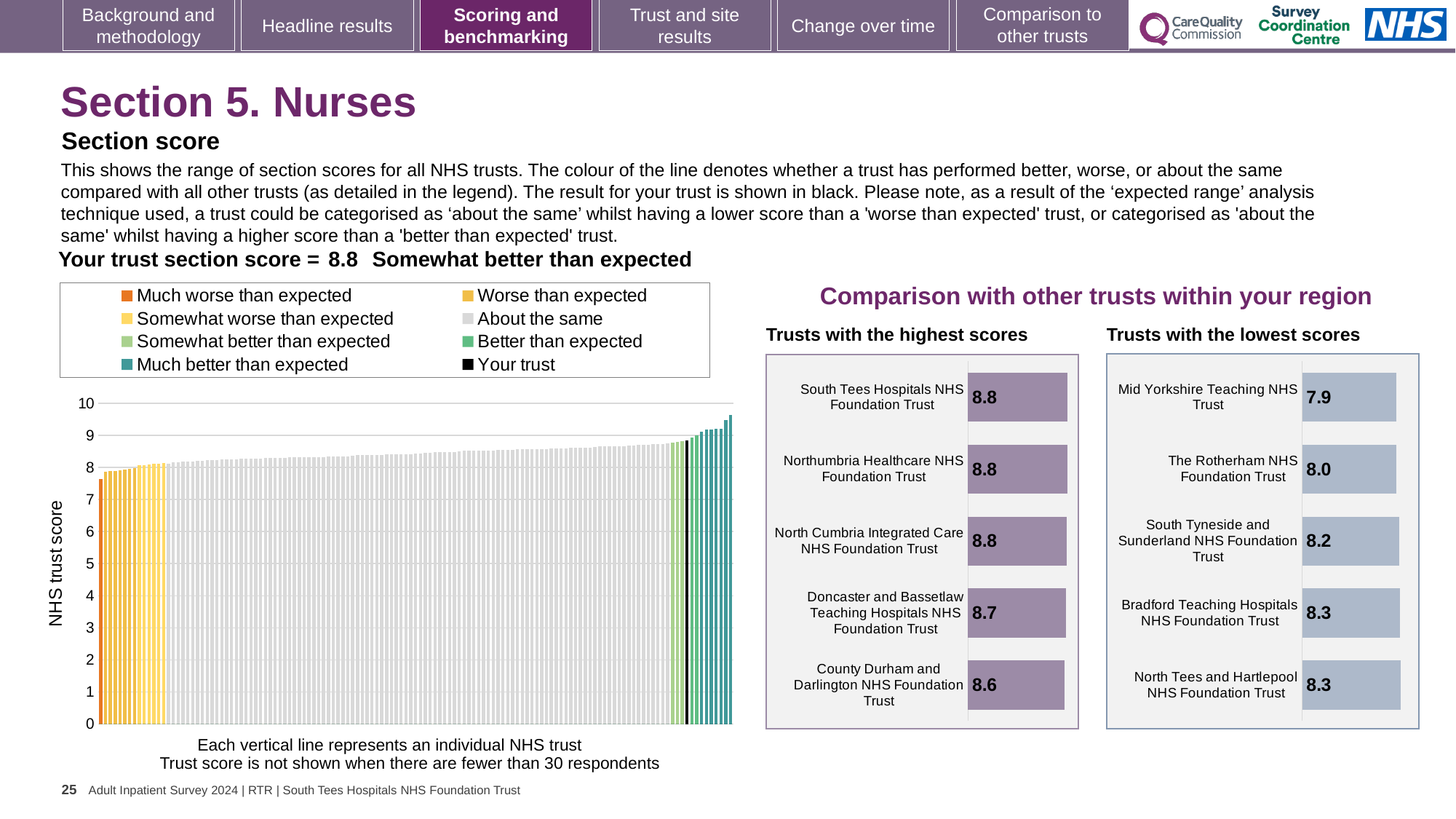
In the 'Trusts with the highest scores' chart, what is the score for Doncaster and Bassetlaw Teaching Hospitals NHS Foundation Trust? 8.7 In the 'Trusts with the lowest scores' chart, what is the score for The Rotherham NHS Foundation Trust? 8.0 In the 'Trusts with the lowest scores' chart, what is the difference between the scores of North Tees and Hartlepool NHS Foundation Trust and Mid Yorkshire Teaching NHS Trust? 0.4 In the NHS trust score chart on the left, is the value of the leftmost (orange) bar greater or less than 8? less In the NHS trust score chart on the left, do the values rise or fall from left to right? Rise In the NHS trust score chart on the left, what colour represents 'Your trust' in the legend? Black In the 'Trusts with the highest scores' chart, which trust has the lowest score? County Durham and Darlington NHS Foundation Trust How many entries does the legend of the NHS trust score chart list? 8 In the 'Trusts with the highest scores' chart, which has the higher score: South Tees Hospitals NHS Foundation Trust or County Durham and Darlington NHS Foundation Trust? South Tees Hospitals NHS Foundation Trust How many trusts are shown in the 'Trusts with the lowest scores' chart? 5 In the 'Trusts with the lowest scores' chart, which trust has the lowest score? Mid Yorkshire Teaching NHS Trust What kind of chart is the NHS trust score chart on the left of the slide? Bar chart